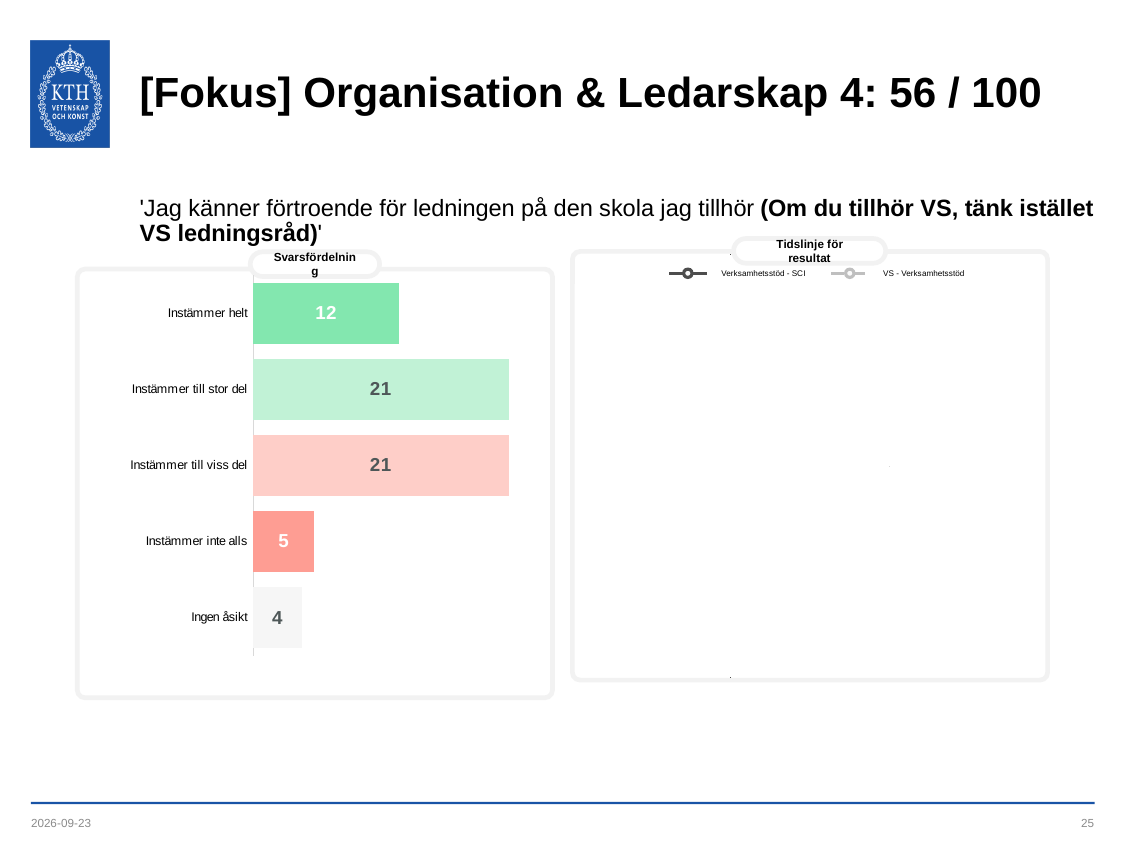
How many series does the legend of the Tidslinje för resultat chart list? 2 In the Svarsfördelning chart, what is the difference between Instämmer till stor del and Instämmer helt? 9 In the Svarsfördelning chart, what is the difference between Instämmer helt and Instämmer inte alls? 7 In the Svarsfördelning chart, which is larger: Instämmer till viss del or Ingen åsikt? Instämmer till viss del In the Svarsfördelning chart, what is the value for Instämmer inte alls? 5 In the Svarsfördelning chart, what is the value for Ingen åsikt? 4 How many categories does the Svarsfördelning chart show? 5 In the Svarsfördelning chart, which is larger: Instämmer helt or Instämmer inte alls? Instämmer helt What kind of chart is the Svarsfördelning chart? Bar chart In the Svarsfördelning chart, what is the value for Instämmer till stor del? 21 In the Svarsfördelning chart, what is the value for Instämmer helt? 12 In the Svarsfördelning chart, which category has the lowest value? Ingen åsikt